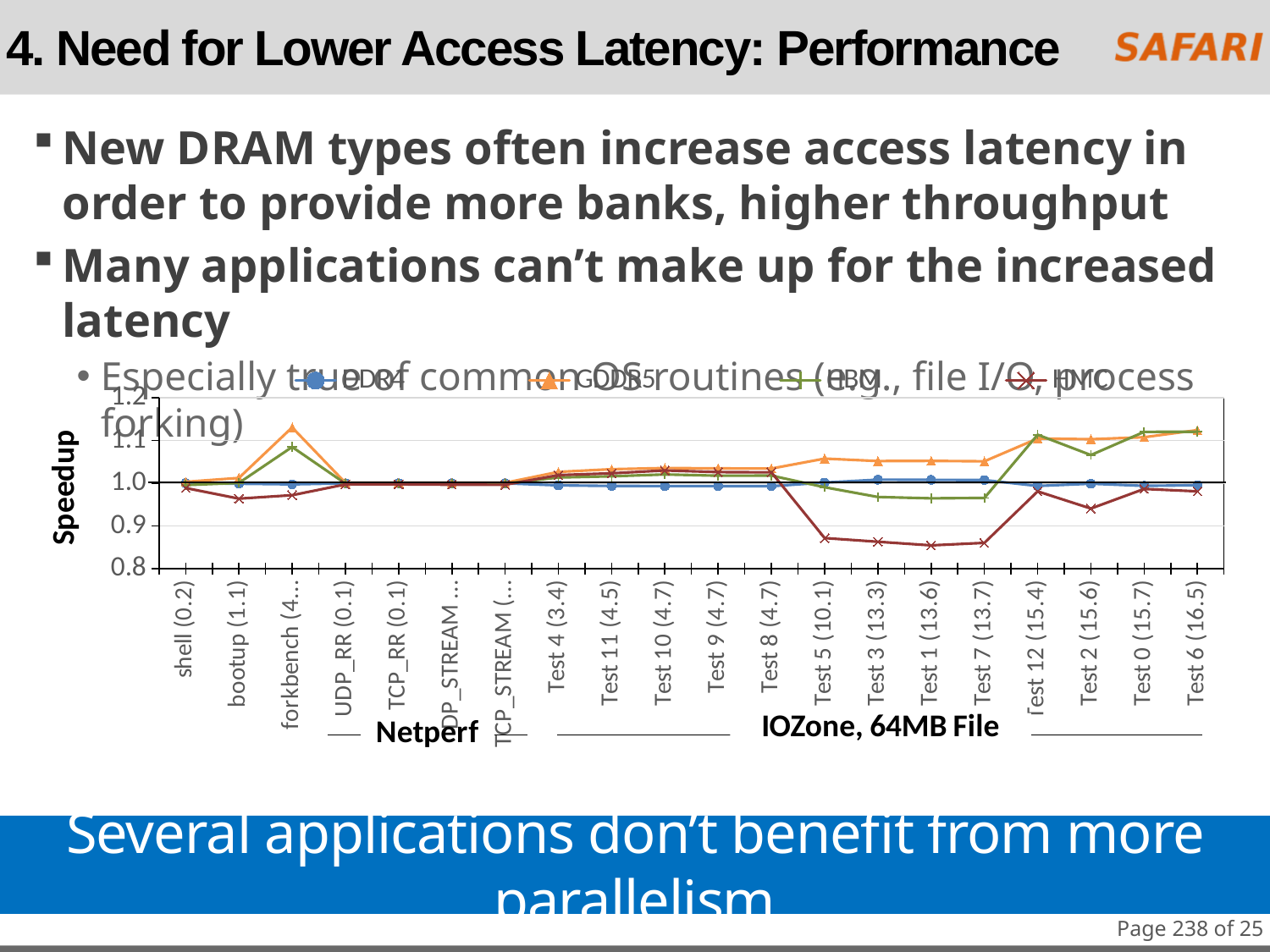
What are the two benchmark group labels shown beneath the x axis of the chart? Netperf and IOZone, 64MB File Is the HBM value for Test 1 (13.6) greater or less than 1.0? less At forkbench, which series has the higher speedup, DDR4 or GDDR5? GDDR5 How many categories are plotted along the x axis of the chart? 20 Is the GDDR5 value for Test 5 (10.1) greater or less than 1.0? greater Is the GDDR5 value for forkbench greater or less than 1.0? greater What is the label of the y axis of the chart? Speedup How many series does the chart's legend list? 4 At Test 5 (10.1), which series has the higher speedup, GDDR5 or HBM? GDDR5 What kind of chart is shown on the slide? line chart